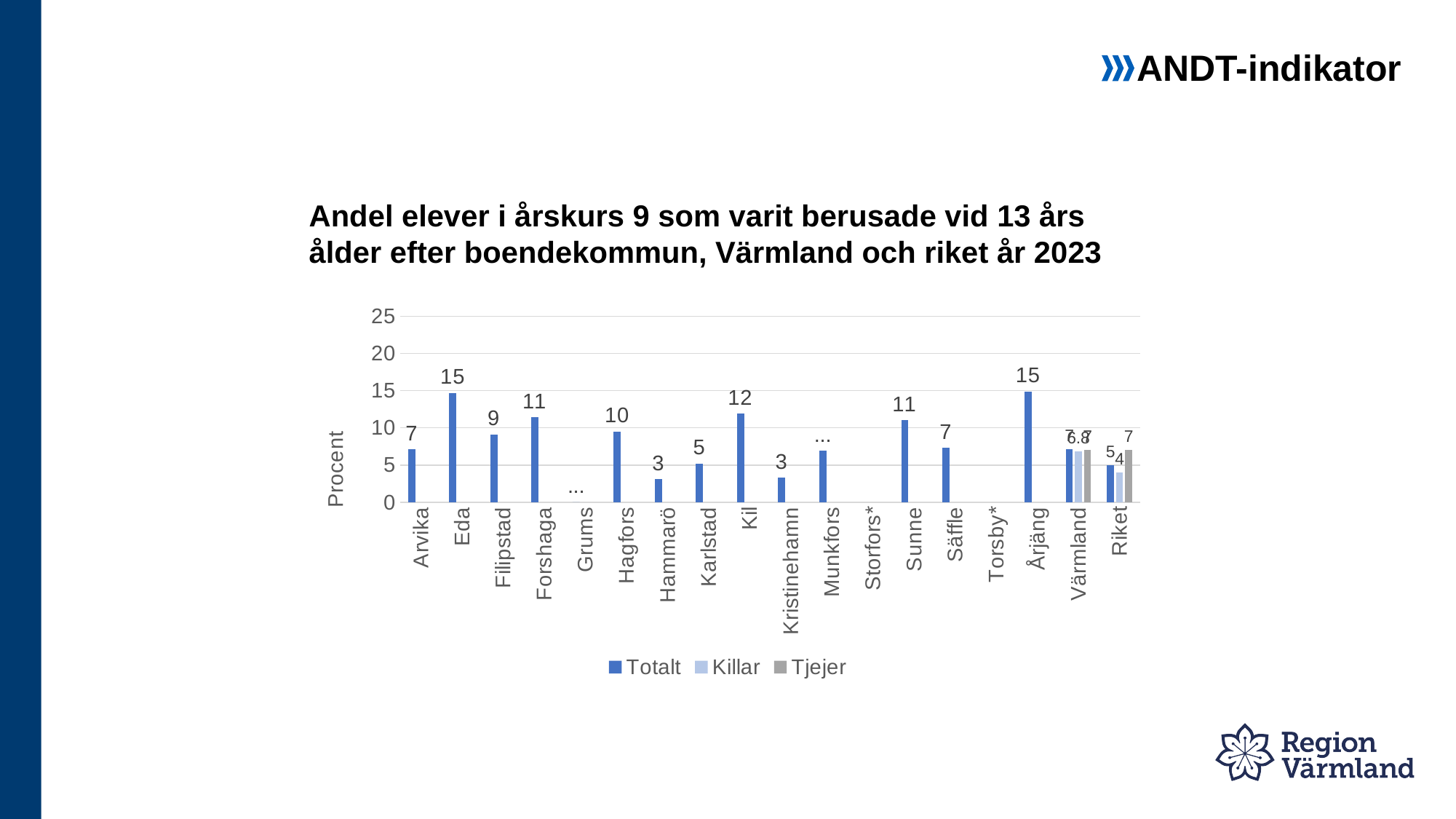
How many series does the legend list? 3 What is the Killar value for Riket? 4 What kind of chart is shown on the slide? bar chart How many categories are shown on the x axis? 18 What is the Tjejer value for Riket? 7 Is the Totalt value for Sunne greater or less than 10? greater What is the difference between the Totalt values for Eda and Arvika? 8 What is the difference between the Tjejer and Killar values for Riket? 3 Which has a higher Totalt value, Forshaga or Filipstad? Forshaga What is the Totalt value for Hagfors? 10 What is the Totalt value for Karlstad? 5 What is the Totalt value for Kil? 12